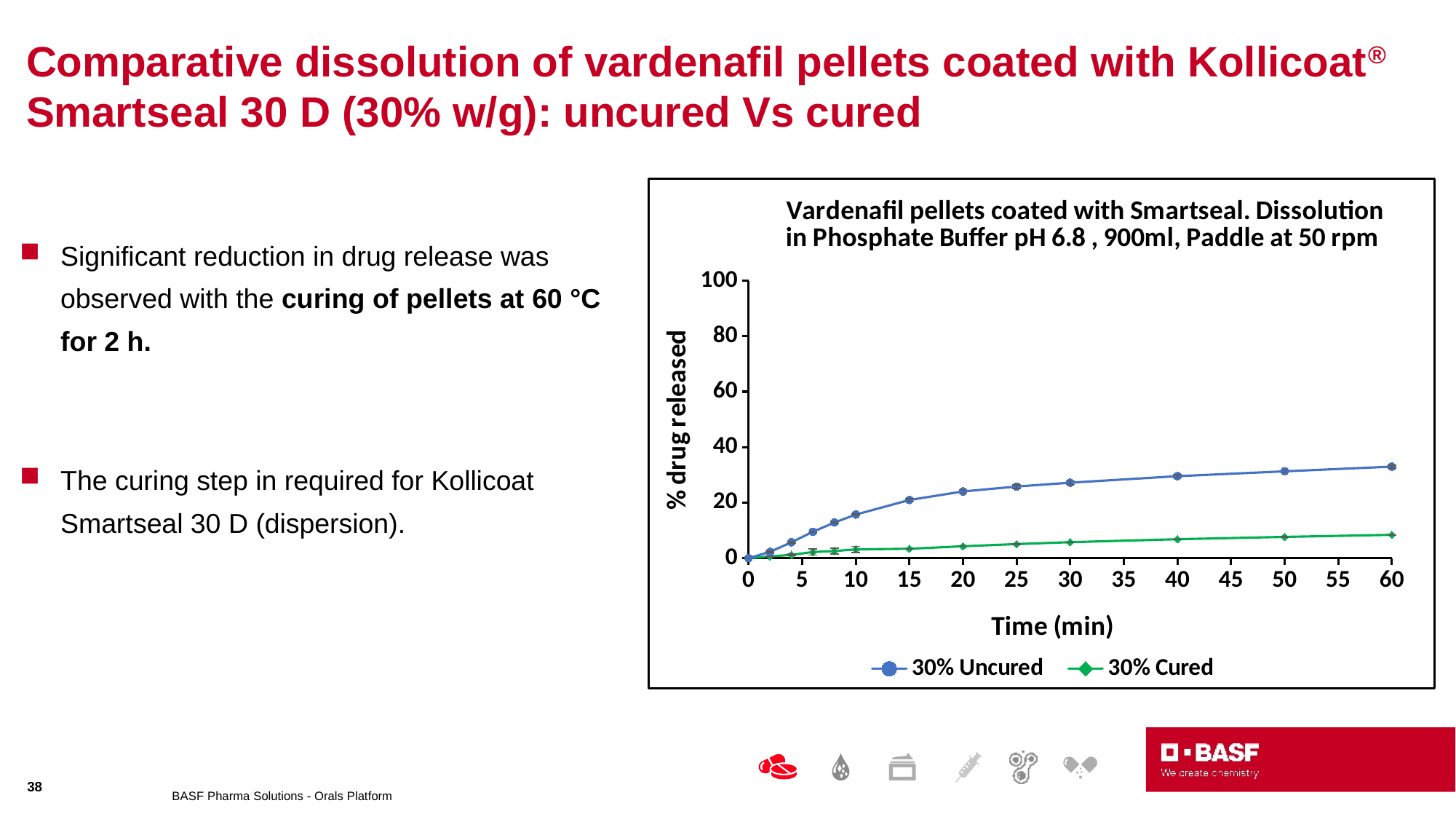
What is the label of the y axis of the chart? % drug released What kind of chart is shown on the slide? line chart Is the value for 30% Uncured at 60 min greater or less than 40? less Is the value for 30% Uncured at 10 min greater or less than 20? less Does the 30% Uncured series rise or fall as time increases along the x axis? rise What are the two series named in the chart legend? 30% Uncured and 30% Cured Does the 30% Cured series rise or fall as time increases along the x axis? rise How many series does the chart legend list? 2 Is the value for 30% Cured at 60 min greater or less than 20? less Which series has the higher value at 60 min, 30% Uncured or 30% Cured? 30% Uncured